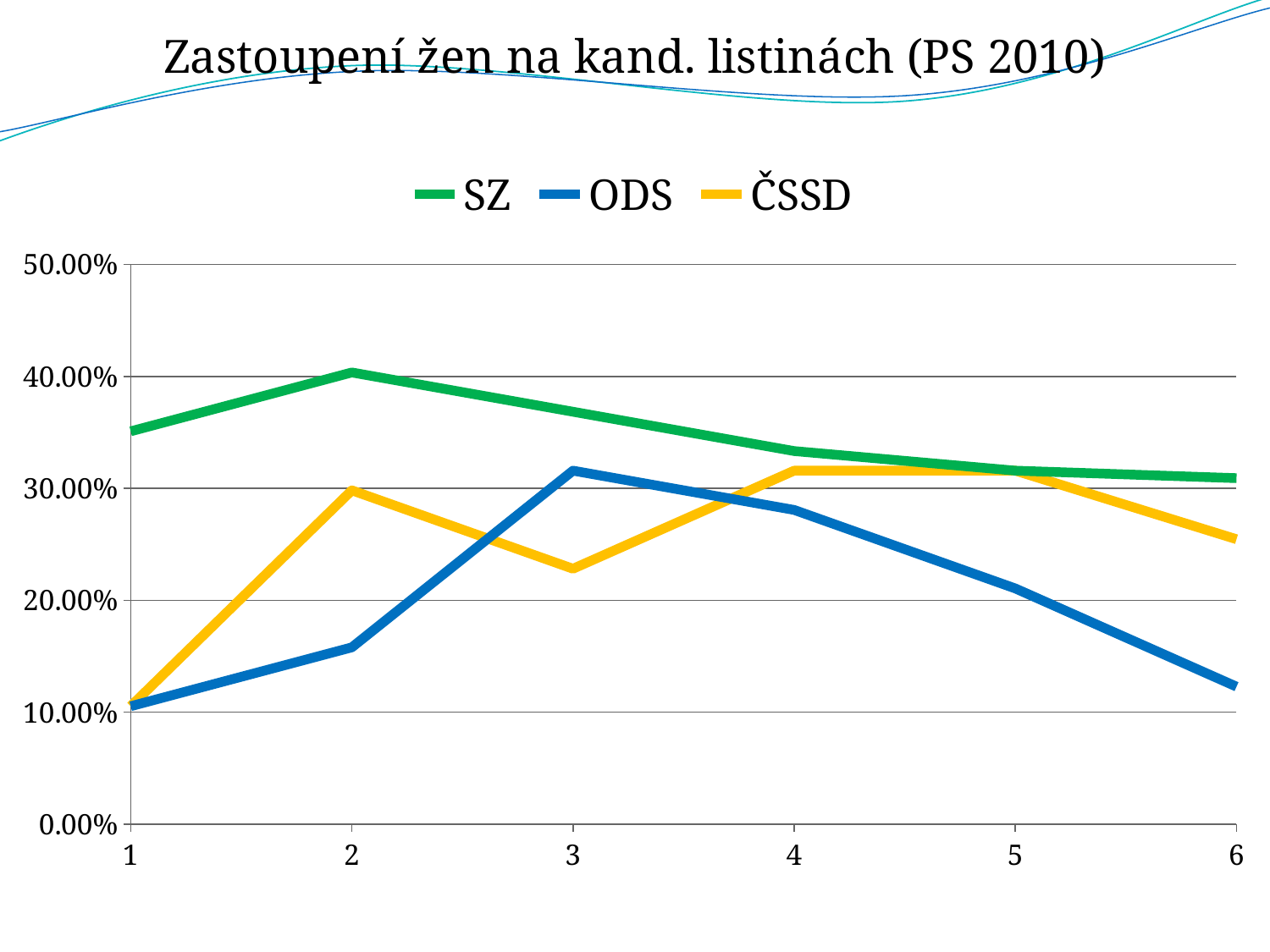
How many series does the legend list? 3 Does the ODS series rise or fall from position 3 to position 6? fall Is the value for ODS at position 1 greater or less than 20.00%? less Is the value for ČSSD at position 3 greater or less than 20.00%? greater At which x-axis position does the SZ series reach its highest value? 2 What kind of chart is shown on the slide? line chart How many points are plotted along the x axis for each series? 6 Is the value for SZ at position 1 greater or less than 30.00%? greater What is the title of the chart? Zastoupení žen na kand. listinách (PS 2010) At position 3, which series has the larger value, ODS or ČSSD? ODS At which x-axis position does the ČSSD series have its lowest value? 1